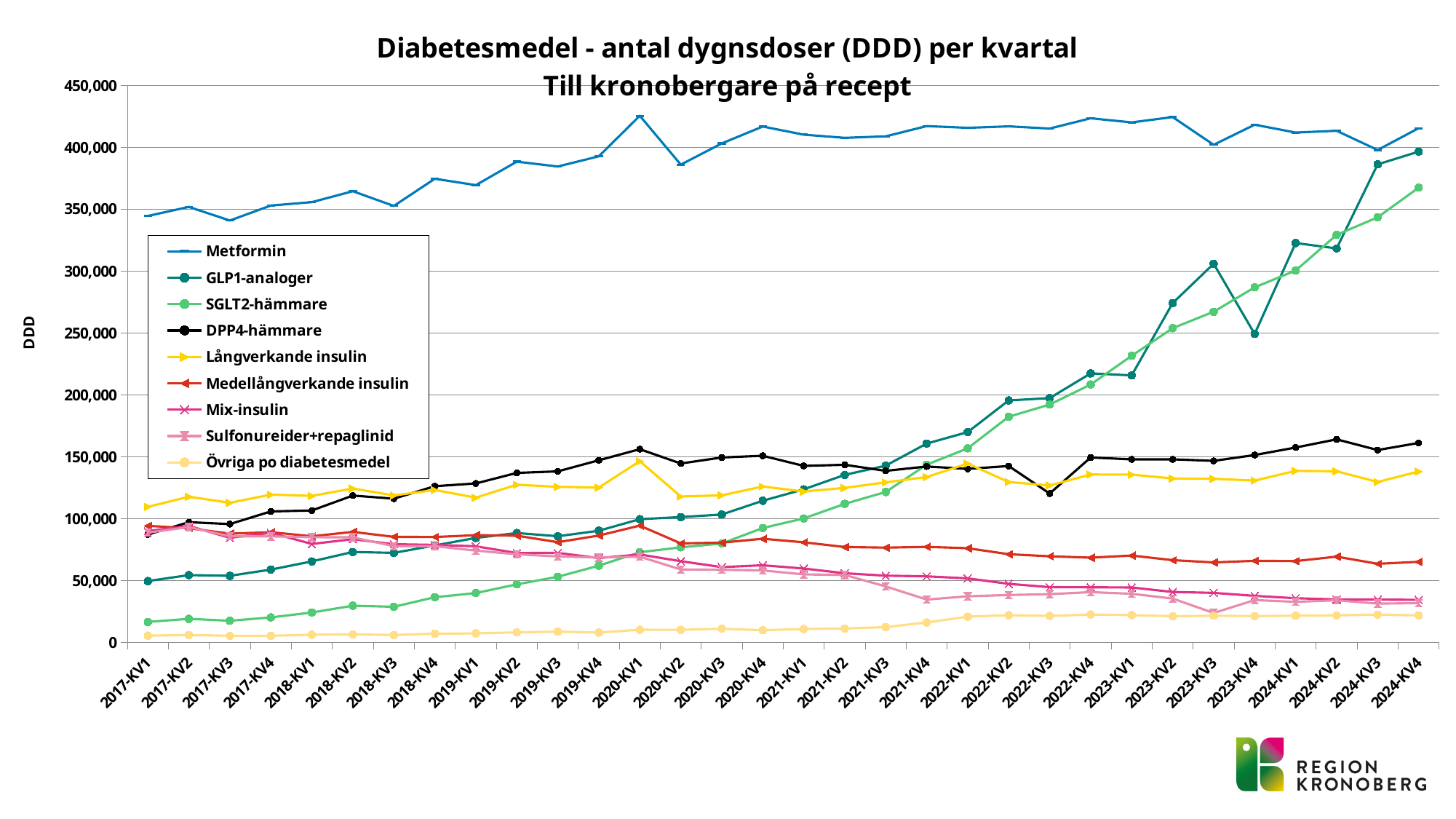
Which series has the highest value in 2024-KV4? Metformin Does the Sulfonureider+repaglinid series rise or fall from 2017-KV1 to 2024-KV4? fall What is the label on the y axis? DDD Is the value for GLP1-analoger in 2024-KV4 greater or less than 350,000? greater Is the value for DPP4-hämmare in 2022-KV3 greater or less than 150,000? less How many series does the legend list? 9 In 2024-KV4, which is larger: GLP1-analoger or SGLT2-hämmare? GLP1-analoger How many quarters are plotted along the x axis? 32 Does the SGLT2-hämmare series rise or fall from 2017-KV1 to 2024-KV4? rise Which series has the lowest value in 2017-KV1? Övriga po diabetesmedel Is the value for Metformin in 2024-KV4 greater or less than 400,000? greater What kind of chart is shown on the slide? line chart